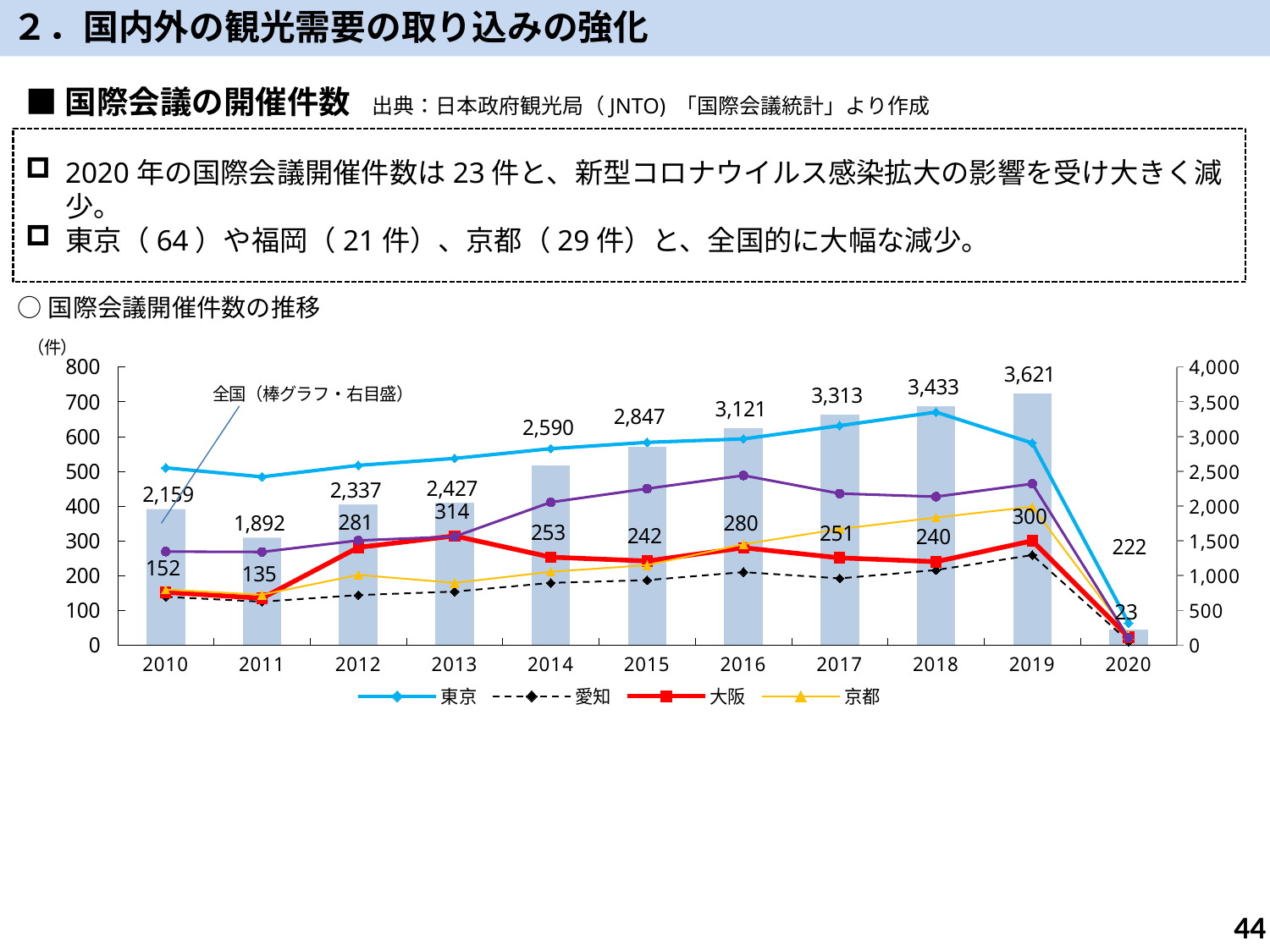
How many series does the legend list? 4 In which year is the 全国 bar lowest? 2020 Is the value for 東京 in 2018 greater or less than 600? greater Which is larger, the 大阪 value in 2013 or in 2019? 2013 What is the value of 大阪 in 2013? 314 What is the difference between the 全国 values for 2019 and 2018? 188 What is the difference between the 大阪 values for 2019 and 2018? 60 What is the value of 全国 (the bars) in 2019? 3,621 How many years are shown on the x axis? 11 What is the value of 大阪 in 2020? 23 What kind of chart is this? Combination bar and line chart In which year is the 全国 bar highest? 2019